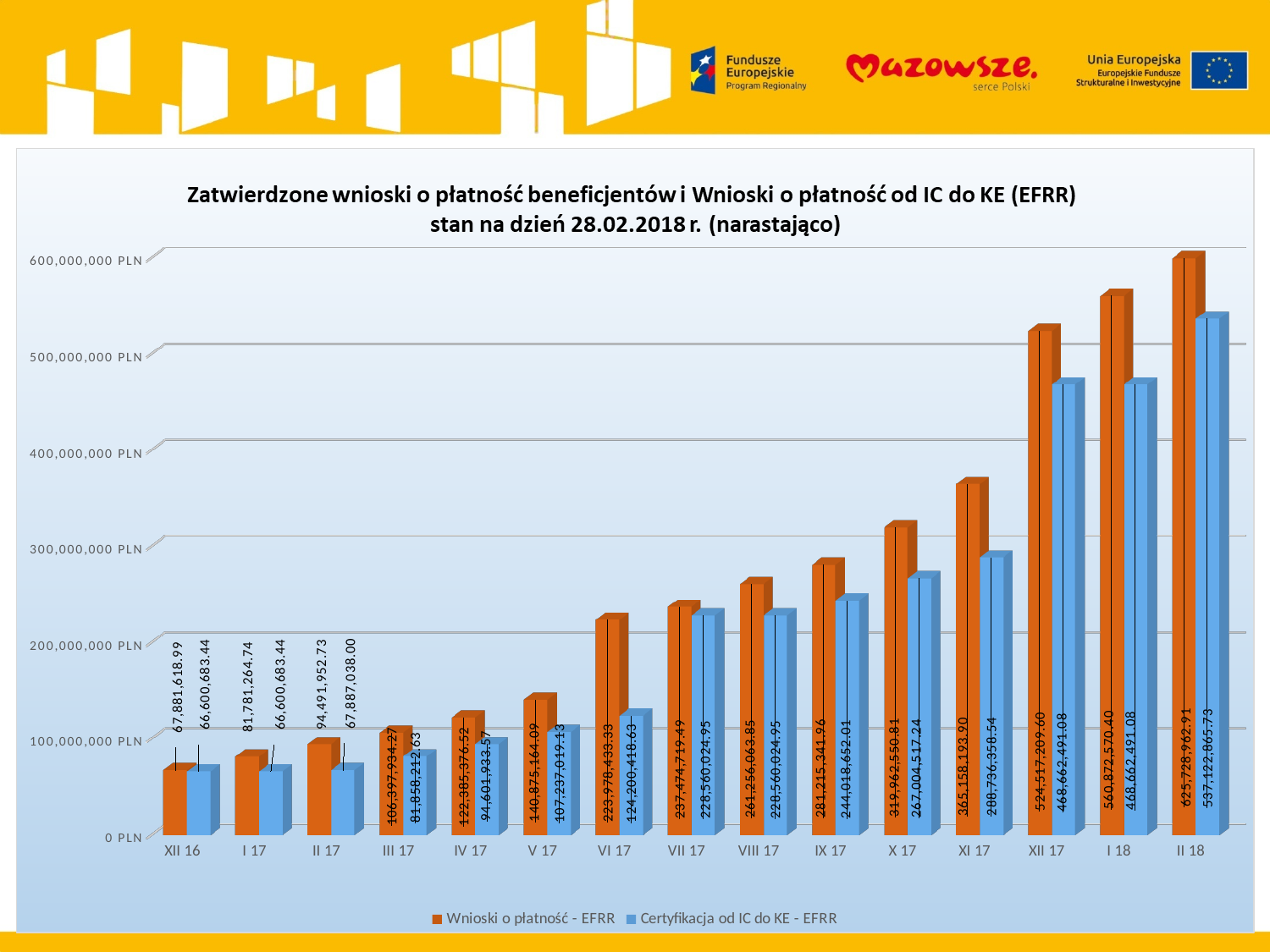
Is the value of 'Wnioski o płatność - EFRR' for XI 17 greater or less than 300,000,000 PLN? greater What is the difference between 'Wnioski o płatność - EFRR' and 'Certyfikacja od IC do KE - EFRR' for II 18? 88,606,097.18 What is the value of 'Wnioski o płatność - EFRR' for II 18? 625,728,962.91 How many time periods are shown on the x axis? 15 How many series does the legend list? 2 What type of chart is shown on the slide? Bar chart What is the value of 'Certyfikacja od IC do KE - EFRR' for I 17? 66,600,683.44 What is the value of 'Certyfikacja od IC do KE - EFRR' for II 18? 537,122,865.73 Which period has the lowest value for 'Wnioski o płatność - EFRR'? XII 16 Do the values of 'Wnioski o płatność - EFRR' rise or fall from XII 16 to II 18? Rise What is the value of 'Wnioski o płatność - EFRR' for XII 16? 67,881,618.99 Which period has the highest value for 'Wnioski o płatność - EFRR'? II 18